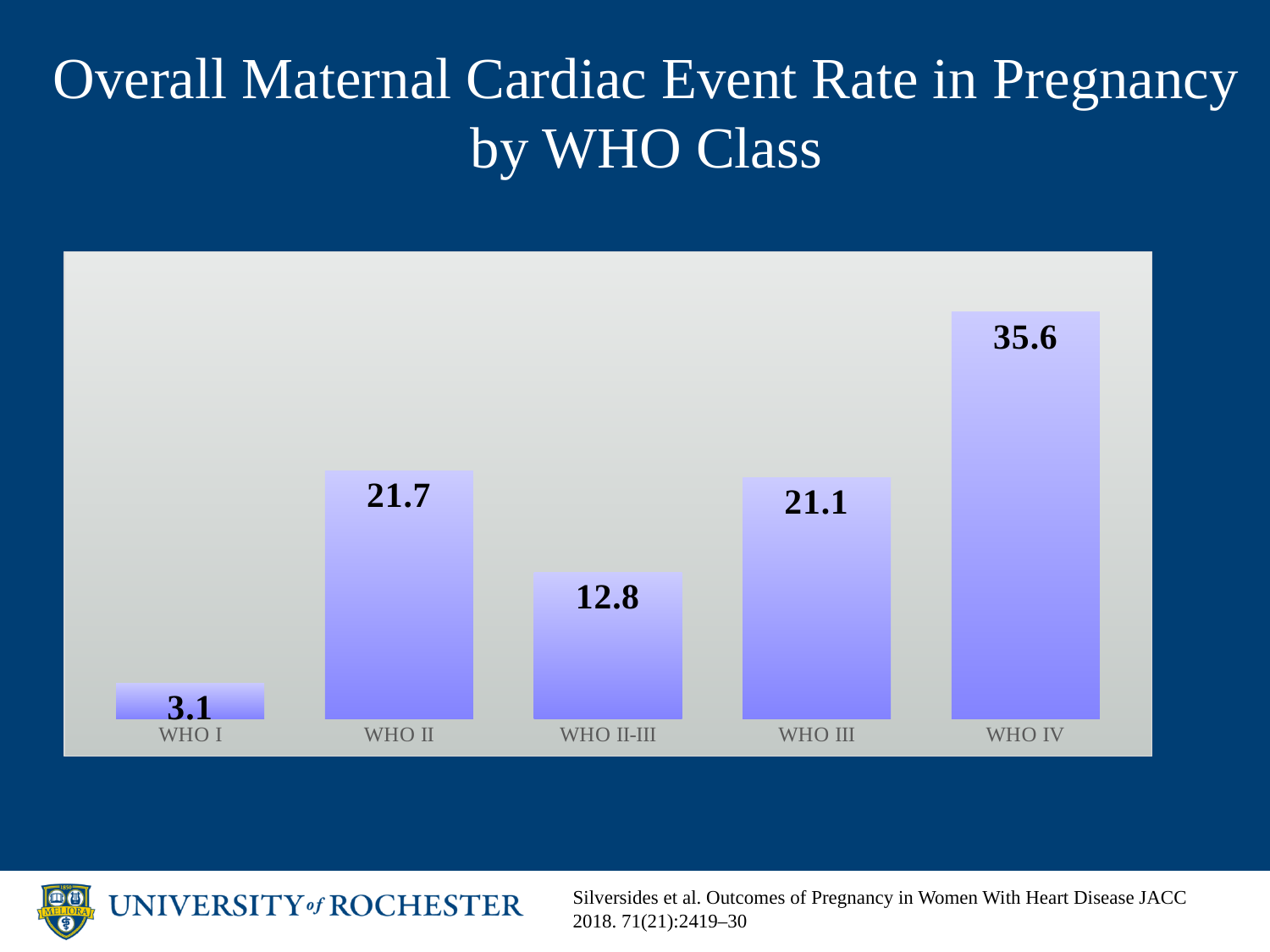
Which WHO class has the lowest value? WHO I Which WHO class has the highest value? WHO IV Which is larger, the value for WHO III or the value for WHO II-III? WHO III What is the difference between the values for WHO IV and WHO I? 32.5 What is the difference between the values for WHO II and WHO II-III? 8.9 How many categories are shown in the chart? 5 What is the value for WHO I? 3.1 What kind of chart is shown on the slide? bar chart What is the value for WHO IV? 35.6 What is the value for WHO II-III? 12.8 What is the value for WHO III? 21.1 What is the title of the slide? Overall Maternal Cardiac Event Rate in Pregnancy by WHO Class